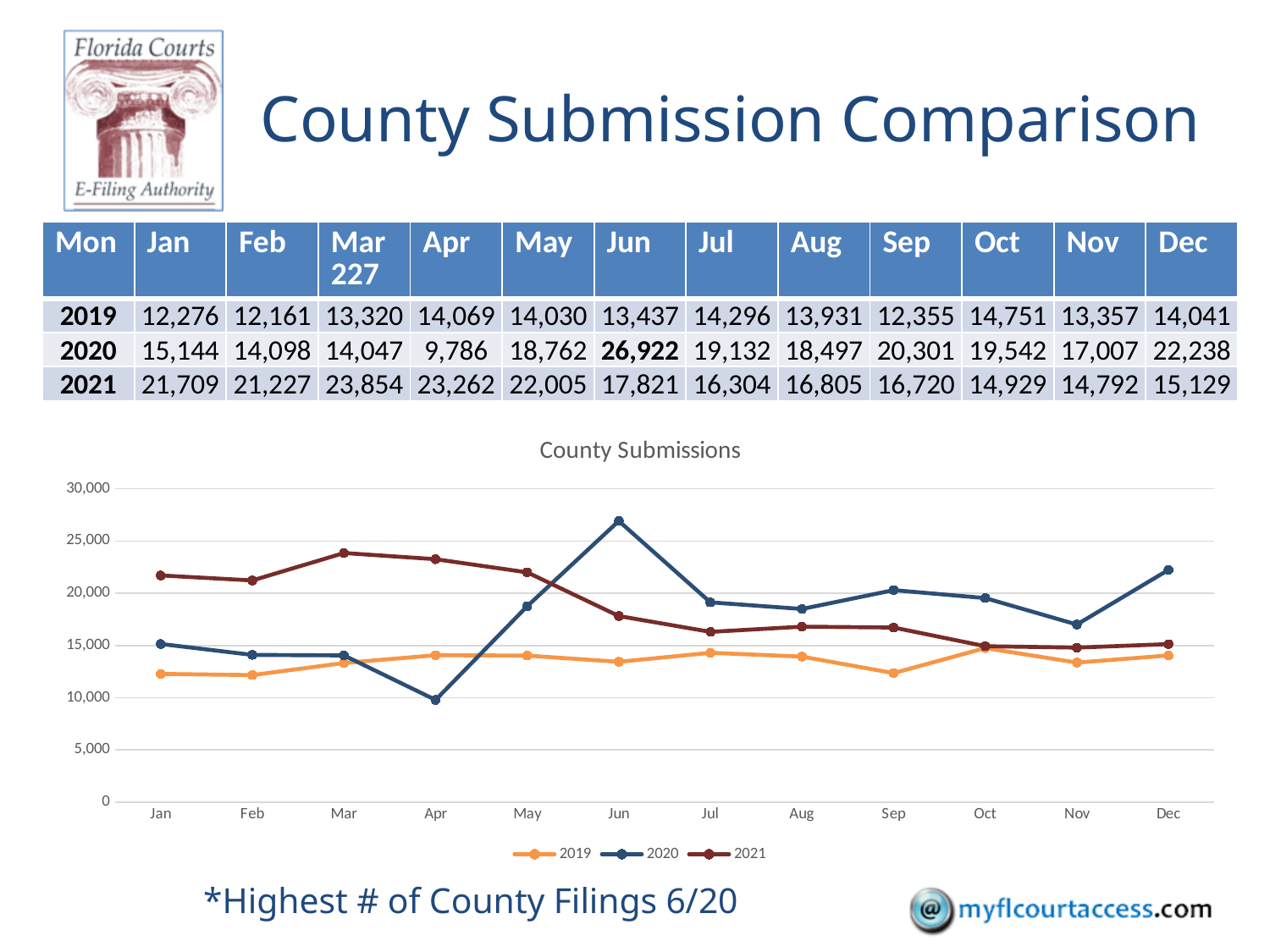
Is the value for 2020 in Apr greater or less than 10,000? less In which month does the 2020 series reach its highest value? Jun What is the difference between the 2020 and 2019 values in Jun? 13,485 Does the 2021 series generally rise or fall from Mar to Dec? fall Which series has the larger value in Dec, 2020 or 2021? 2020 In which month does the 2020 series reach its lowest value? Apr How many months are plotted along the x axis of the County Submissions chart? 12 What is the value for 2020 in Jun? 26,922 How many series does the legend of the County Submissions chart list? 3 What is the value for 2019 in Oct? 14,751 What is the value for 2021 in Mar? 23,854 What type of chart is shown under the title "County Submissions"? Line chart